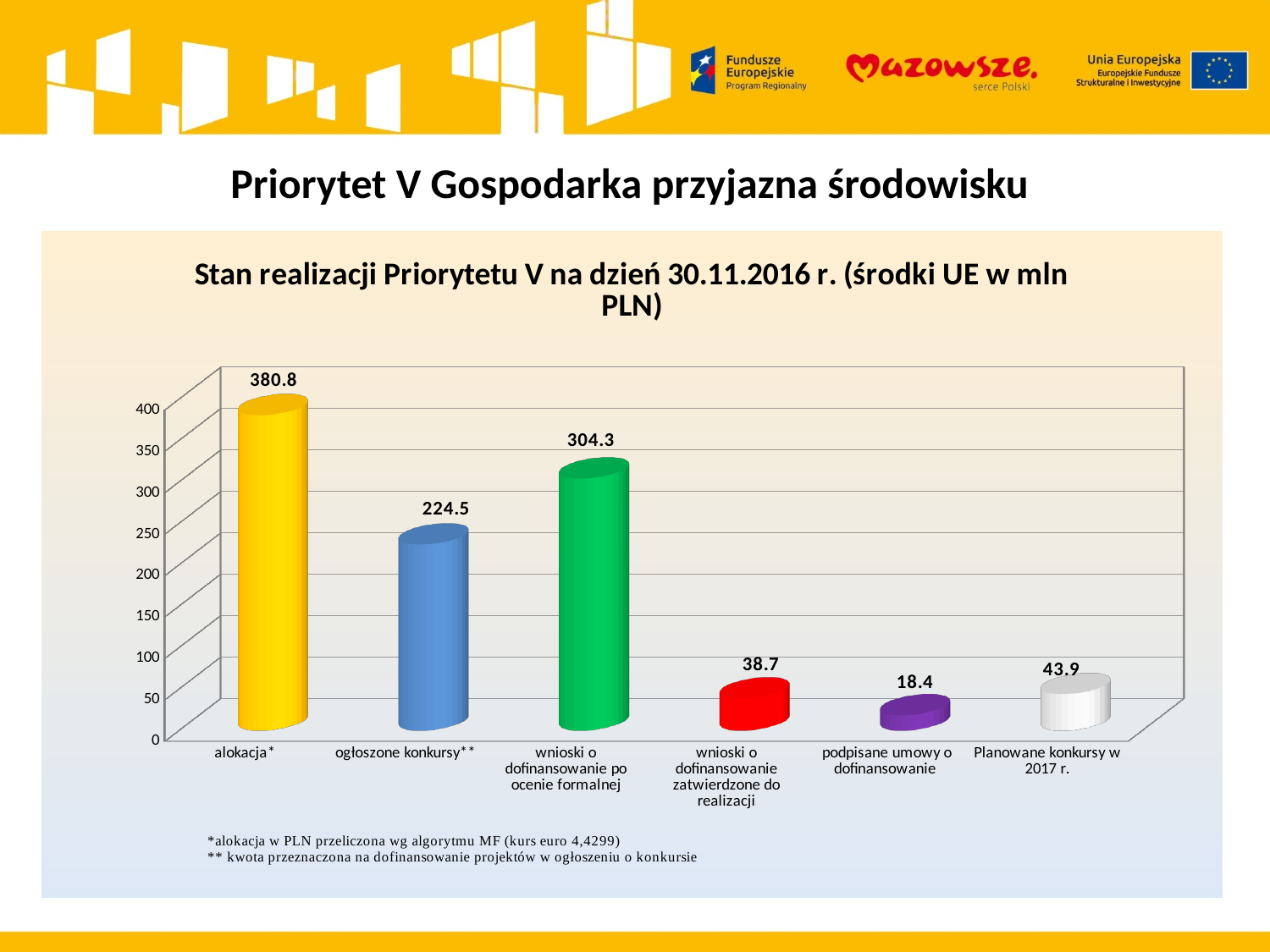
Which category has the lowest value? podpisane umowy o dofinansowanie What is the value for alokacja*? 380.8 Which is larger: the value for wnioski o dofinansowanie zatwierdzone do realizacji or the value for Planowane konkursy w 2017 r.? Planowane konkursy w 2017 r. What is the value for wnioski o dofinansowanie po ocenie formalnej? 304.3 How many categories are shown in the chart? 6 What is the title of the chart? Stan realizacji Priorytetu V na dzień 30.11.2016 r. (środki UE w mln PLN) What kind of chart is shown on the slide? bar chart What is the value for Planowane konkursy w 2017 r.? 43.9 What is the difference between the values for alokacja* and ogłoszone konkursy**? 156.3 Which category has the highest value? alokacja* What is the value for ogłoszone konkursy**? 224.5 What is the value for podpisane umowy o dofinansowanie? 18.4